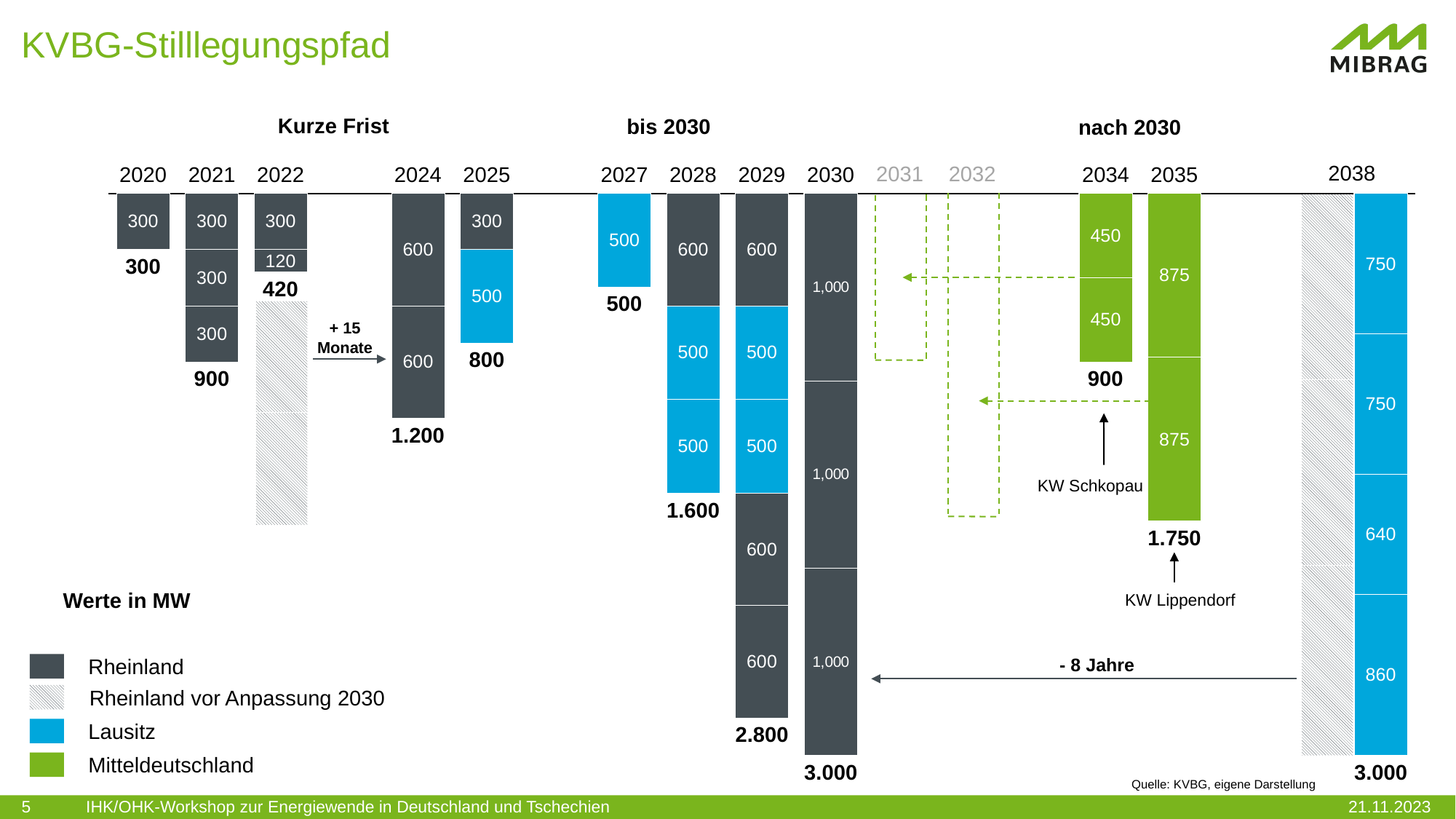
What unit are the values given in, according to the slide? MW Which is larger, the total for 2024 or the total for 2025? 2024 What is the total value shown for 2021? 900 Which year has the lowest total value? 2020 How many entries does the legend list? 4 What is the total value shown for 2022? 420 What type of chart is shown on the slide? Stacked bar chart What is the total value shown for 2035? 1.750 What is the value of the Mitteldeutschland segment in 2034 (each segment)? 450 What is the difference between the totals for 2029 and 2028? 1.200 What is the value of the Lausitz segment in 2025? 500